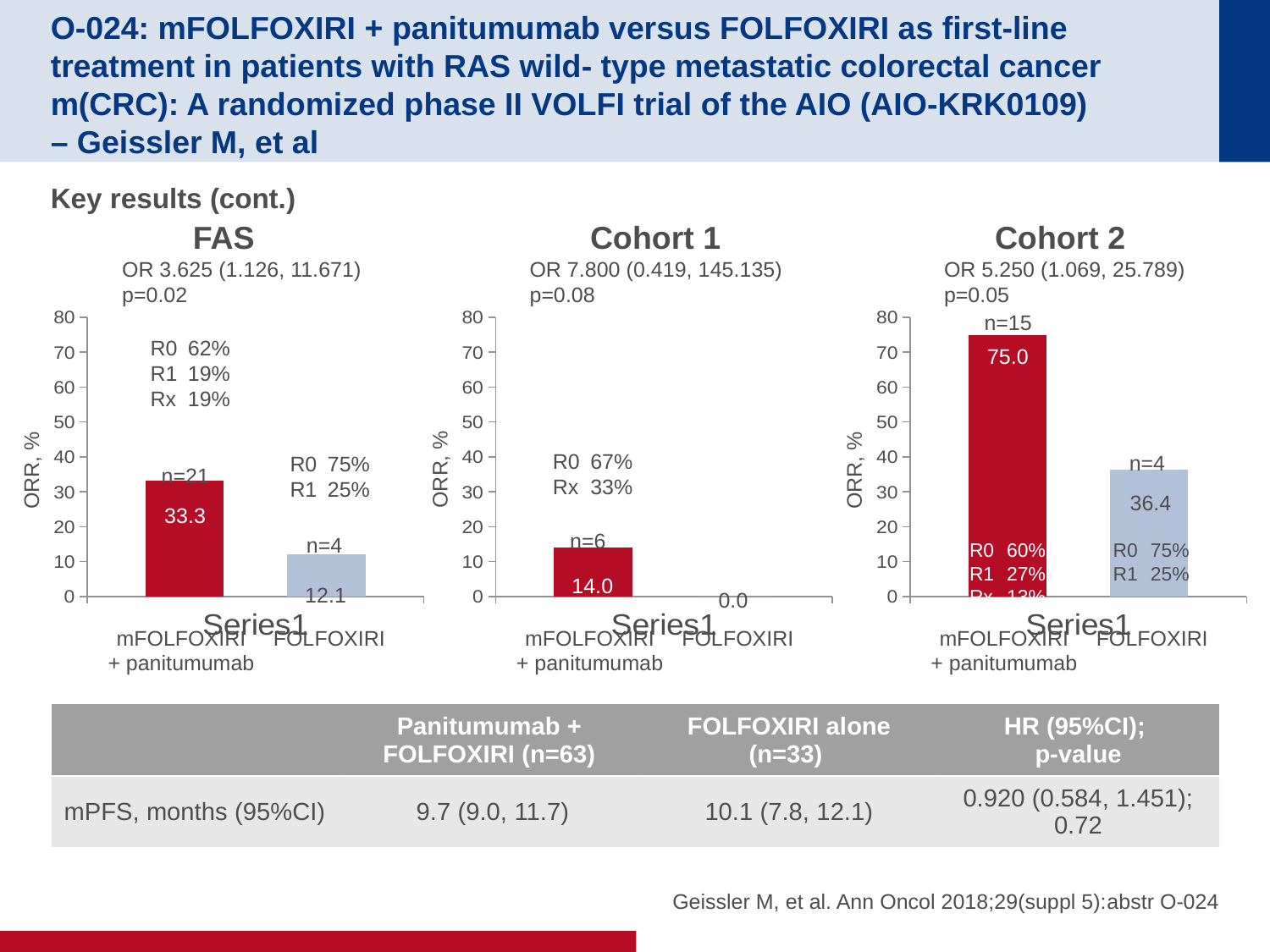
In the Cohort 1 chart, what is the ORR for FOLFOXIRI? 0.0 In the Cohort 2 chart, what is the difference in ORR between mFOLFOXIRI + panitumumab and FOLFOXIRI? 38.6 In the FAS chart, what is the difference in ORR between mFOLFOXIRI + panitumumab and FOLFOXIRI? 21.2 In the FAS chart, what is the ORR for mFOLFOXIRI + panitumumab? 33.3 In the Cohort 2 chart, what is the ORR for mFOLFOXIRI + panitumumab? 75.0 How many bars are shown in the Cohort 2 chart? 2 In the Cohort 2 chart, is the ORR for mFOLFOXIRI + panitumumab greater or less than 70? greater In the Cohort 1 chart, which treatment arm has the higher ORR? mFOLFOXIRI + panitumumab What kind of chart is the FAS chart? Bar chart In the Cohort 1 chart, what is the ORR for mFOLFOXIRI + panitumumab? 14.0 In the Cohort 2 chart, what is the ORR for FOLFOXIRI? 36.4 In the FAS chart, what is the ORR for FOLFOXIRI? 12.1